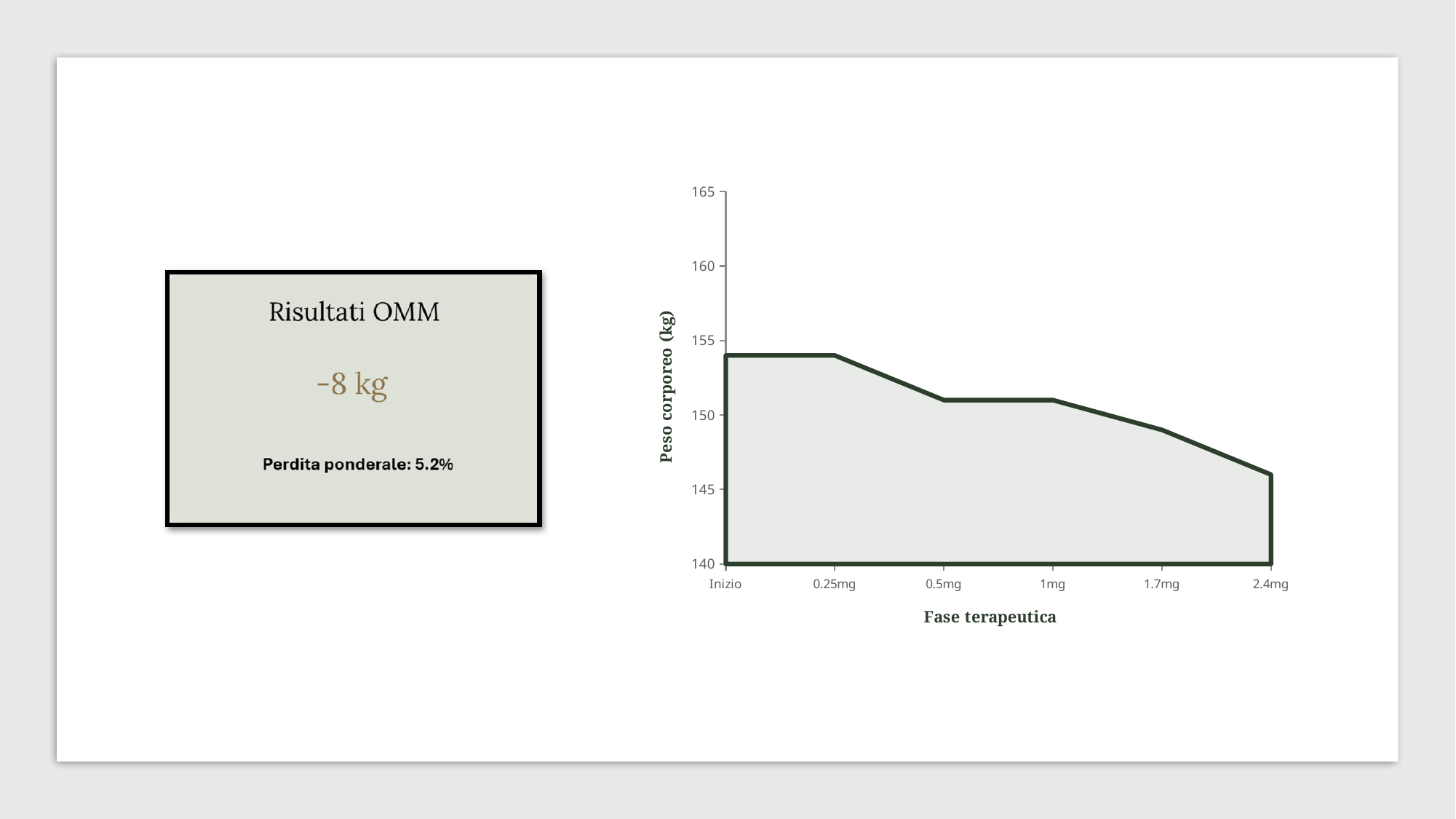
What kind of chart is shown on the slide? Area chart Which has the larger body weight value, Inizio or 2.4mg? Inizio What is the title of the chart's vertical axis? Peso corporeo (kg) Does body weight rise or fall along the x axis from Inizio to 2.4mg? Fall Is the value for Inizio greater or less than 150? greater Which therapy phase has the lowest body weight in the chart? 2.4mg What is the title of the chart's horizontal axis? Fase terapeutica How many therapy phases are plotted along the x axis of the chart? 6 Is the value for 2.4mg greater or less than 150? less Is the value for 0.25mg greater or less than 155? less Which has the larger body weight value, 0.5mg or 1.7mg? 0.5mg